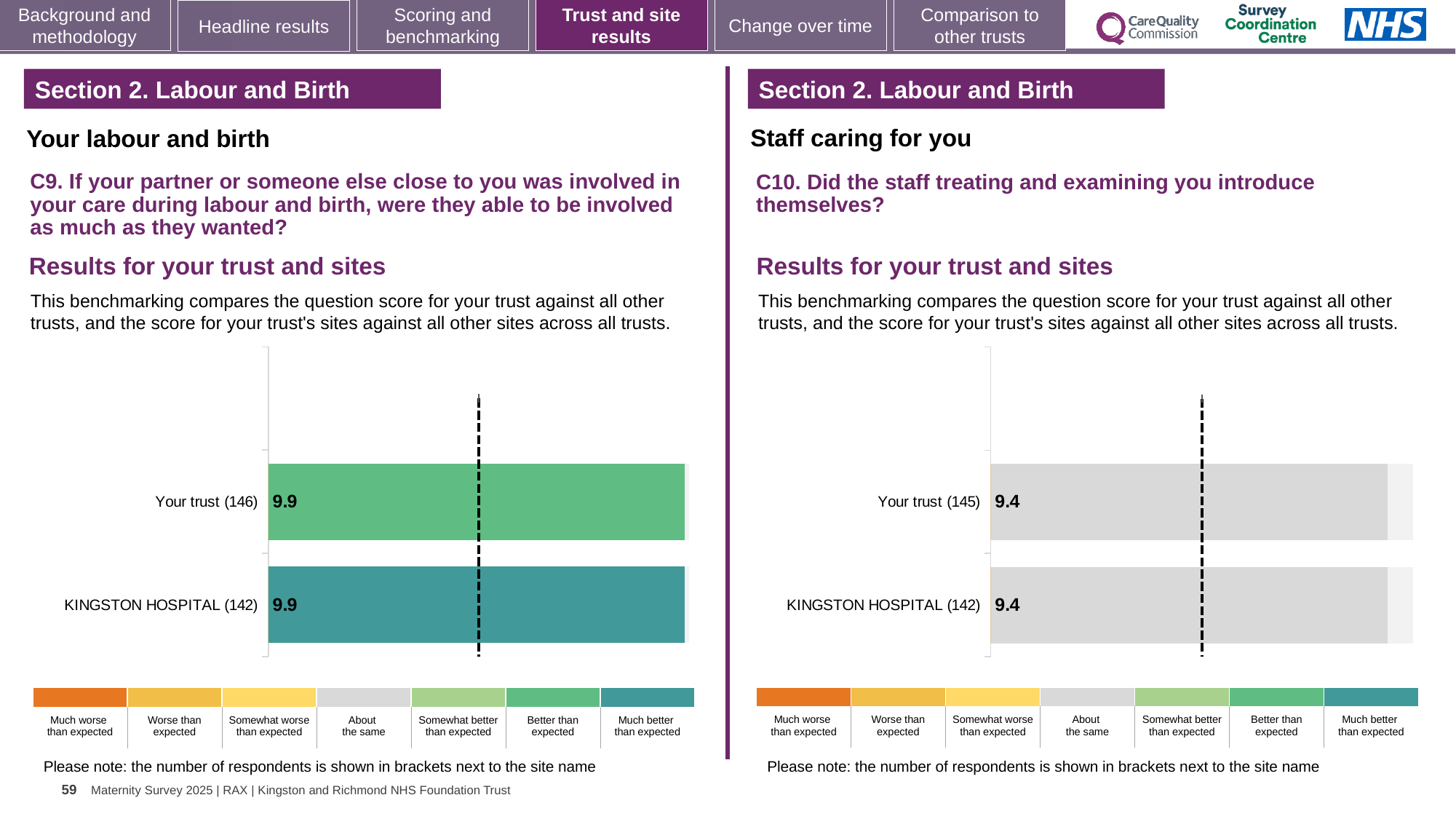
What kind of chart is used on the left (C9)? Bar chart On the left chart (C9), what is the score for KINGSTON HOSPITAL? 9.9 On the right chart (C10), what is the difference between the Your trust score and the KINGSTON HOSPITAL score? 0 On the left chart (C9), how many respondents are shown in brackets for KINGSTON HOSPITAL? 142 On the right chart (C10), how many respondents are shown in brackets for Your trust? 145 On the right chart (C10), what is the score for KINGSTON HOSPITAL? 9.4 On the right chart (C10), what is the score for Your trust? 9.4 On the left chart (C9), what is the score for Your trust? 9.9 On the right chart (C10), which benchmark category does the grey colour of the bars correspond to in the legend? About the same On the left chart (C9), what is the difference between the Your trust score and the KINGSTON HOSPITAL score? 0 How many bars are plotted on the left chart (C9)? 2 How many bars are plotted on the right chart (C10)? 2